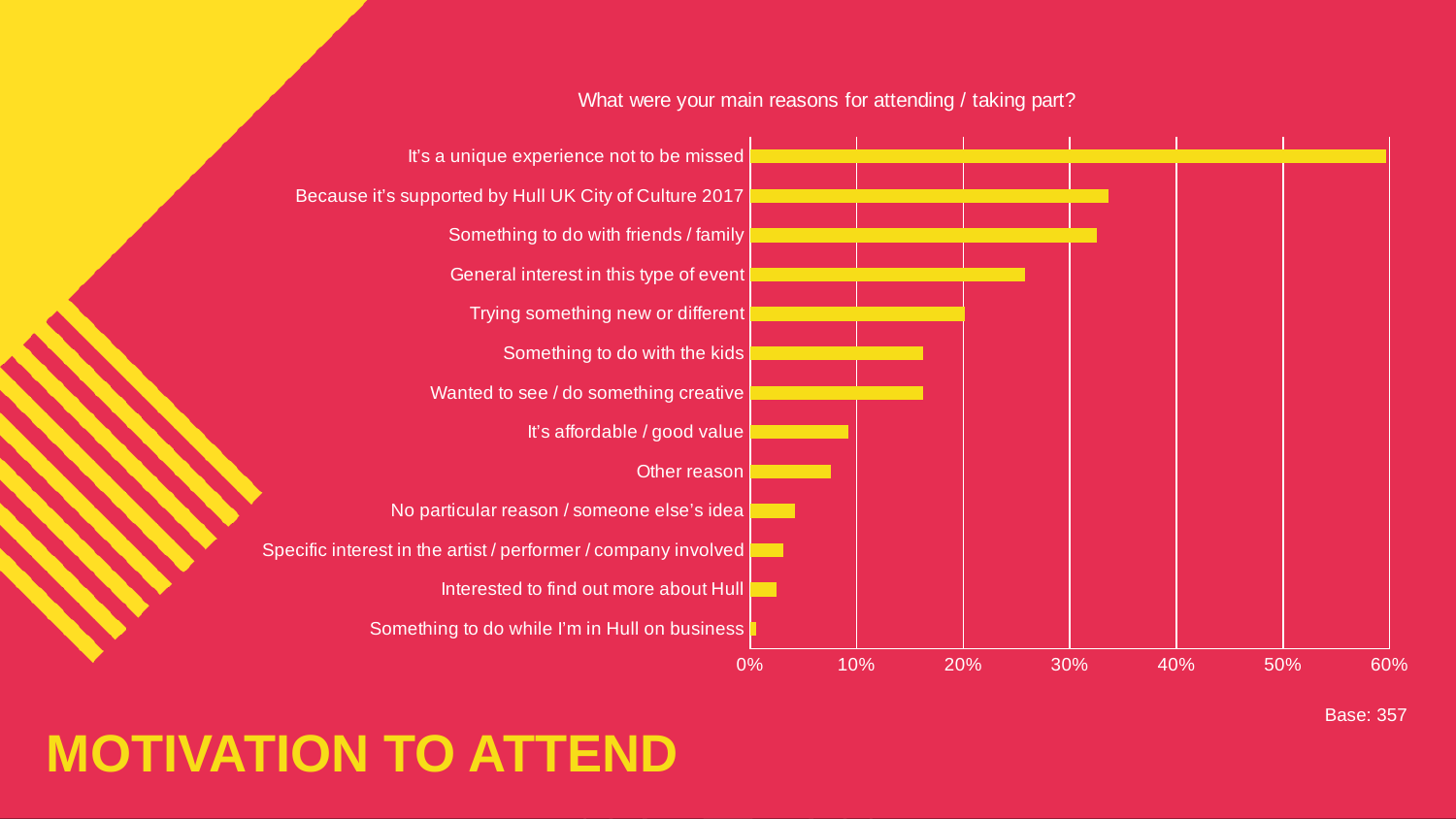
Is the value for 'Because it's supported by Hull UK City of Culture 2017' greater or less than 30%? greater How many reasons (categories) are plotted in the chart? 13 Which reason for attending has the highest value? It's a unique experience not to be missed Is the value for 'General interest in this type of event' greater or less than 30%? less What kind of chart is shown on the slide? bar chart Is the value for 'It's a unique experience not to be missed' greater or less than 50%? greater What base (sample size) is stated for the chart? Base: 357 Which is larger: the value for 'Something to do with friends / family' or the value for 'Trying something new or different'? Something to do with friends / family Which reason for attending has the lowest value? Something to do while I'm in Hull on business What question is shown as the title of the chart? What were your main reasons for attending / taking part?